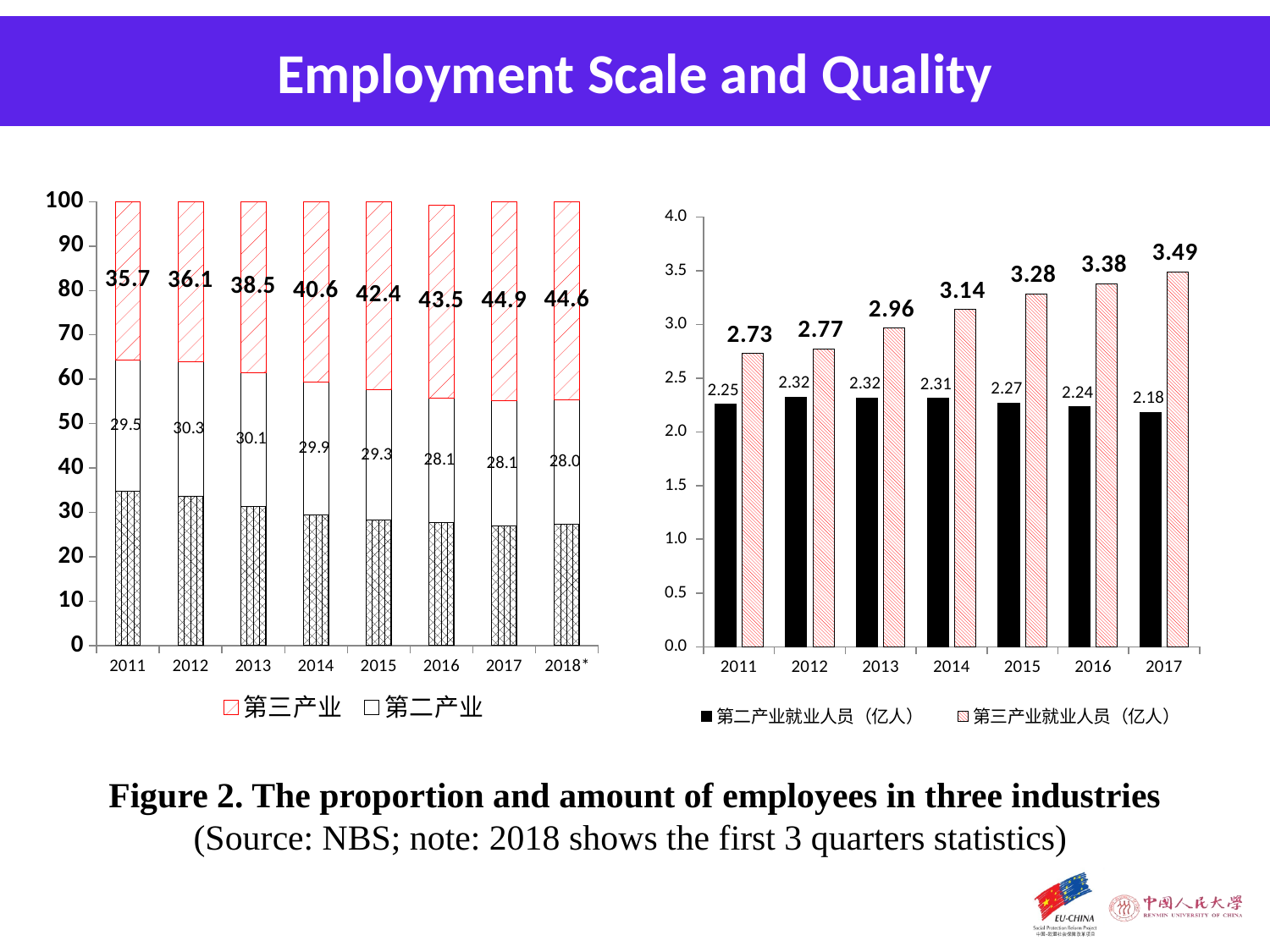
In the left chart, how many years are shown on the x axis? 8 In the right chart, what is the difference between the 第三产业就业人员（亿人） and 第二产业就业人员（亿人） values in 2017? 1.31 In the right chart, what is the value for 第二产业就业人员（亿人） in 2017? 2.18 In the left chart, what is the value labelled for 第三产业 in 2014? 40.6 In the left chart, what is the difference between the 第三产业 values for 2017 and 2011? 9.2 In the left chart, what is the value labelled for 第二产业 in 2018*? 28.0 In the right chart, which year has the lowest value for 第二产业就业人员（亿人）? 2017 In the left chart, which year has the highest labelled value for 第三产业? 2017 In the right chart, how many series does the legend list? 2 What kind of chart is the right chart? bar chart In the right chart, what is the value for 第三产业就业人员（亿人） in 2015? 3.28 In the left chart, does the labelled value for 第三产业 rise or fall from 2011 to 2017? rise